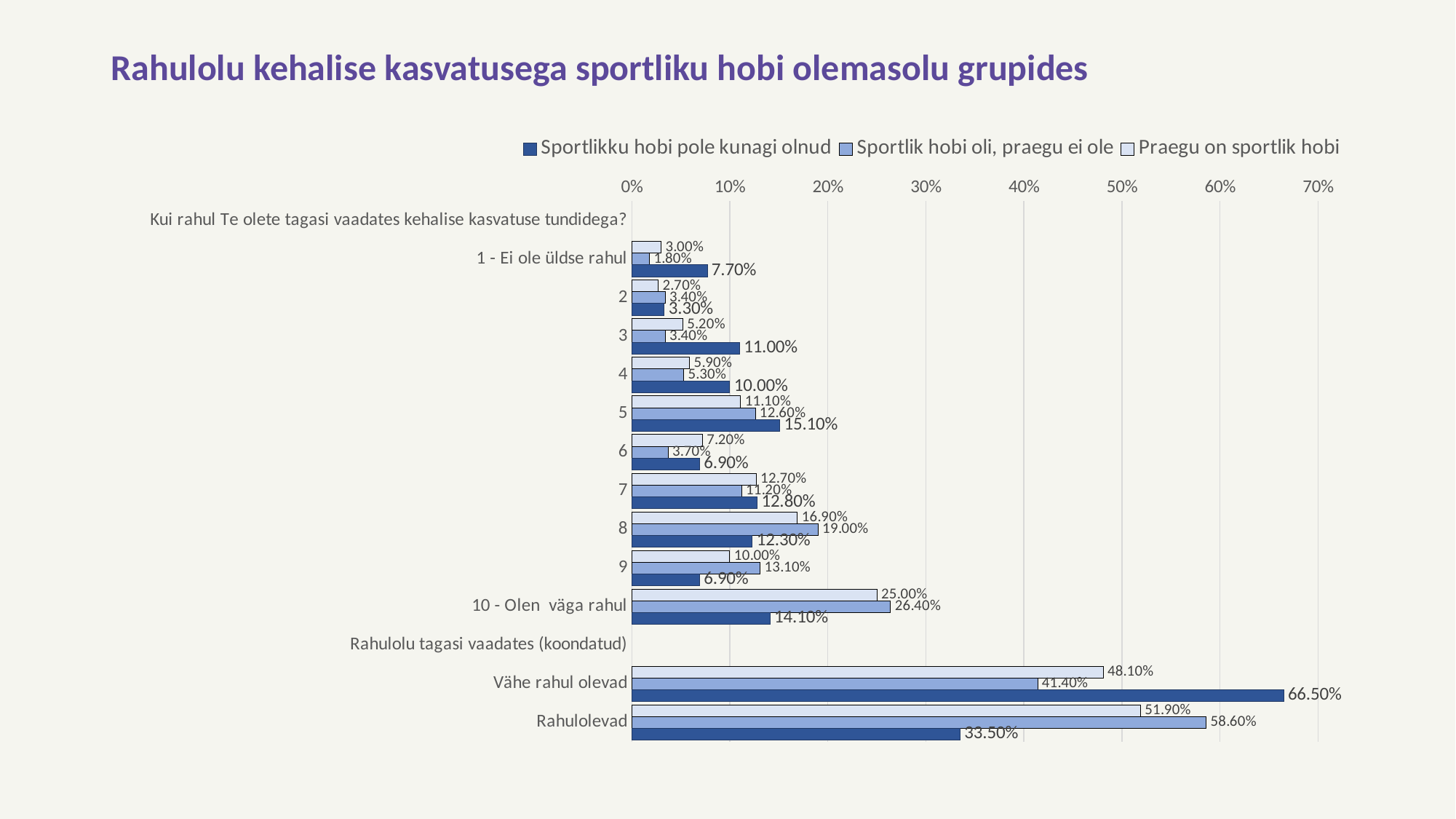
How many series does the legend list? 3 Which series has the lowest value for "Vähe rahul olevad"? Sportlik hobi oli, praegu ei ole Which series has the highest value for "Rahulolevad"? Sportlik hobi oli, praegu ei ole For "10 - Olen väga rahul", which is larger: the "Sportlik hobi oli, praegu ei ole" value or the "Sportlikku hobi pole kunagi olnud" value? Sportlik hobi oli, praegu ei ole What is the value for "Vähe rahul olevad" in the "Sportlikku hobi pole kunagi olnud" series? 66.50% What kind of chart is shown on the slide? Bar chart What is the value for "Rahulolevad" in the "Sportlik hobi oli, praegu ei ole" series? 58.60% What is the difference between the "Sportlikku hobi pole kunagi olnud" and "Praegu on sportlik hobi" values for "Vähe rahul olevad"? 18.40% What is the title of the chart? Rahulolu kehalise kasvatusega sportliku hobi olemasolu grupides What is the value for "10 - Olen väga rahul" in the "Praegu on sportlik hobi" series? 25.00% What is the value for category 8 in the "Sportlik hobi oli, praegu ei ole" series? 19.00% Is the value for "Rahulolevad" in the "Sportlikku hobi pole kunagi olnud" series greater or less than 40%? less